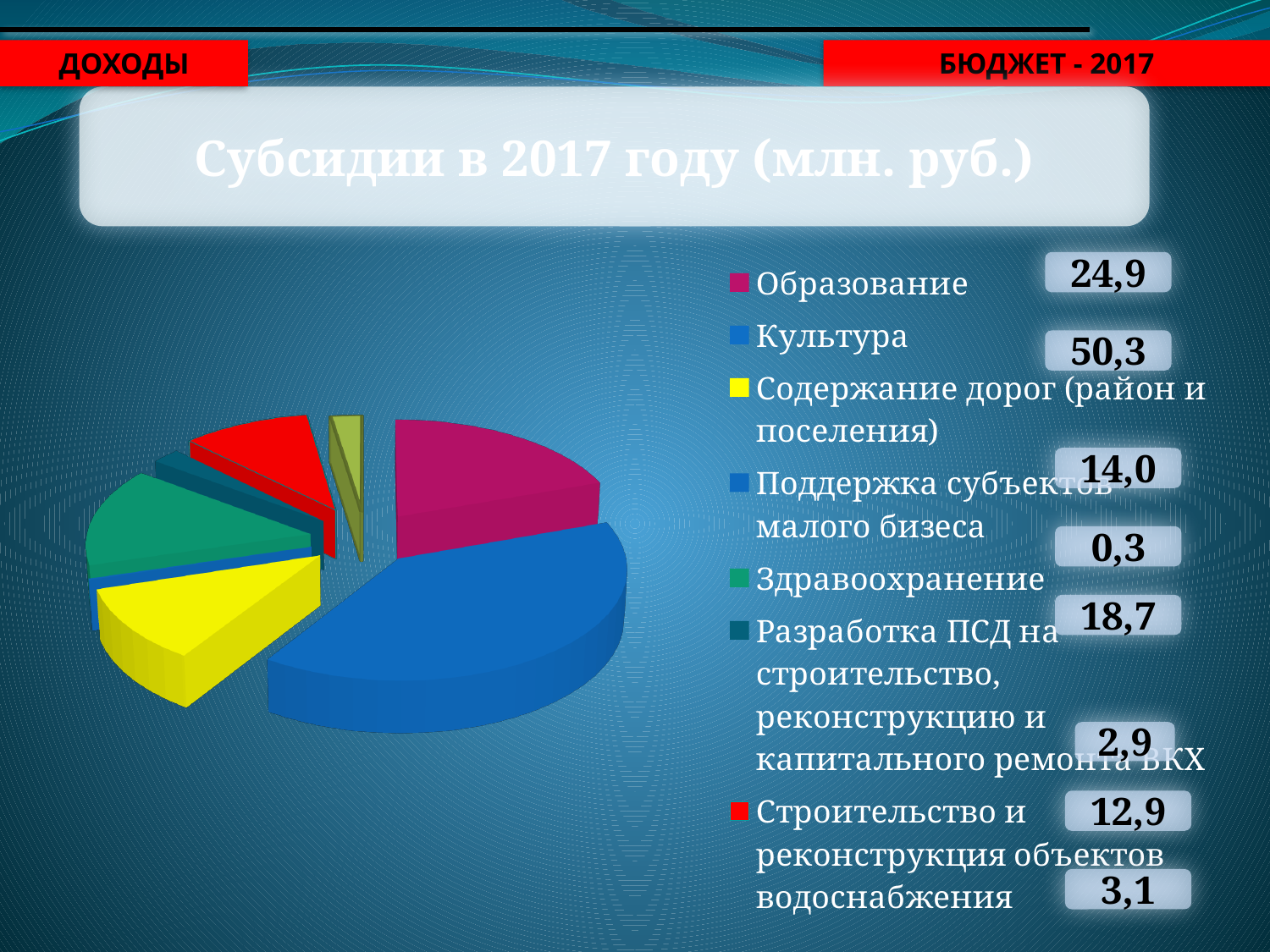
What is the difference between the values for Культура and Образование? 25,4 What is the value for Культура? 50,3 What kind of chart is shown on the slide? pie chart What is the title of the chart? Субсидии в 2017 году (млн. руб.) Which category has the largest value? Культура Which legend category has the smallest value? Поддержка субъектов малого бизнеса What is the value for Здравоохранение? 18,7 What is the value for Содержание дорог (район и поселения)? 14,0 What is the value for Образование? 24,9 What is the value for Строительство и реконструкция объектов водоснабжения? 12,9 Which is larger, Образование or Здравоохранение? Образование What is the value for Поддержка субъектов малого бизнеса? 0,3